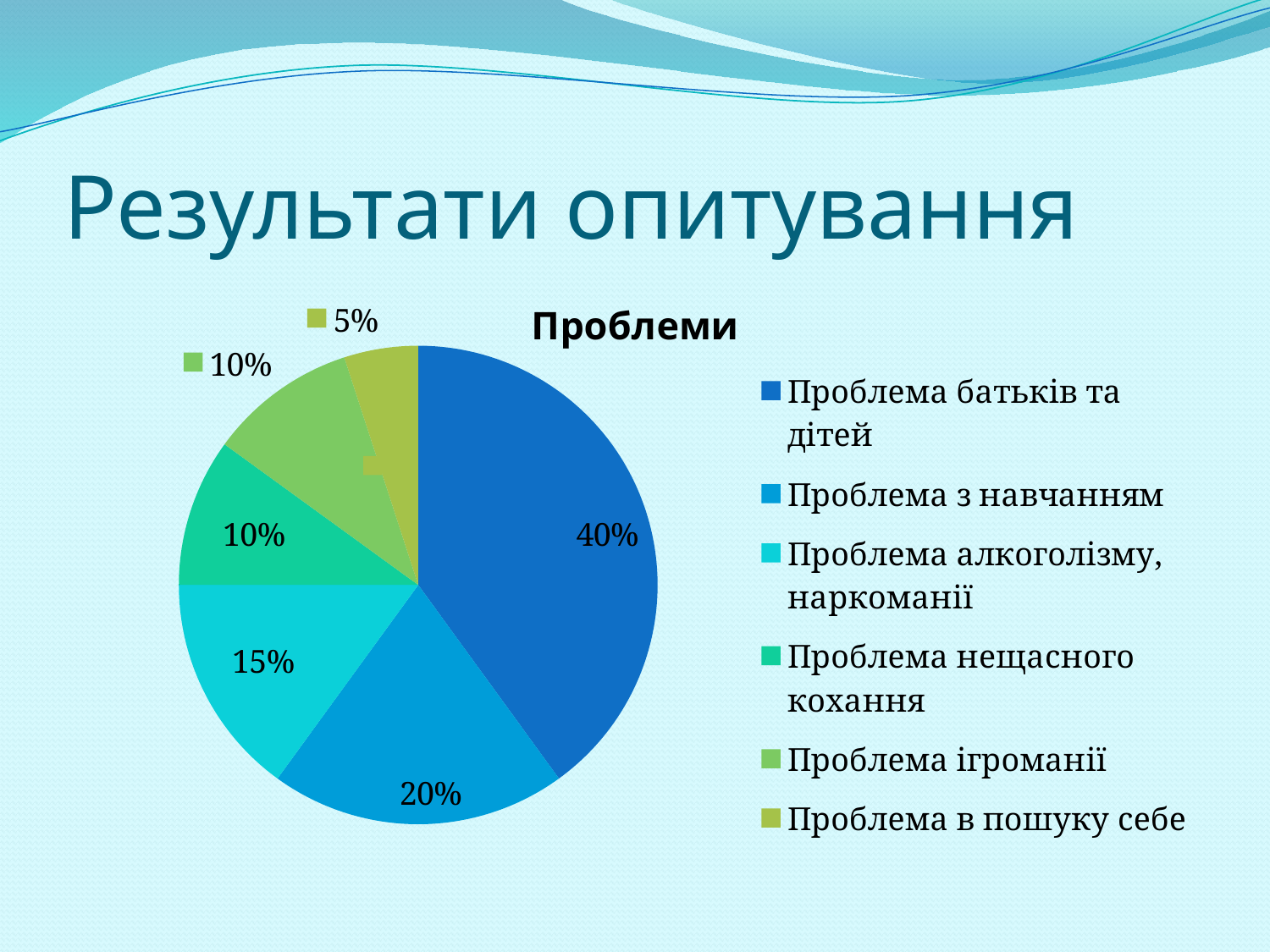
What is the value shown for "Проблема алкоголізму, наркоманії"? 15% What is the value shown for "Проблема з навчанням"? 20% What is the value shown for "Проблема в пошуку себе"? 5% What is the difference between the shares of "Проблема батьків та дітей" and "Проблема з навчанням"? 20% What type of chart is shown on the slide? Pie chart What is the title of the chart? Проблеми Which is larger: the share for "Проблема алкоголізму, наркоманії" or the share for "Проблема ігроманії"? Проблема алкоголізму, наркоманії Which category has the smallest slice of the pie? Проблема в пошуку себе Which category has the largest slice of the pie? Проблема батьків та дітей What share of the pie does "Проблема батьків та дітей" take? 40% How many categories does the legend list? 6 What is the combined share of "Проблема нещасного кохання" and "Проблема ігроманії"? 20%